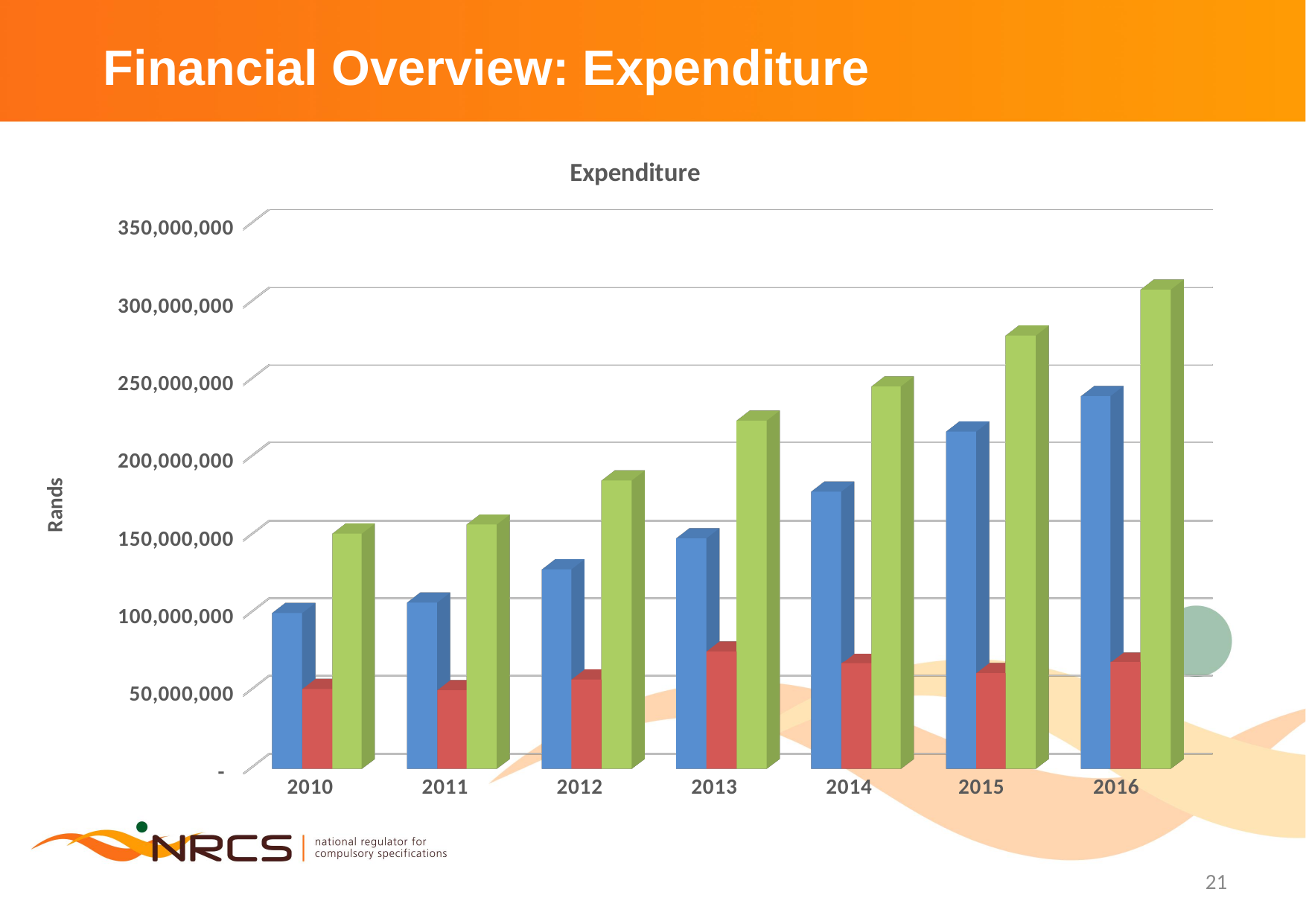
In which year is the green bar the shortest? 2010 Which is larger in 2013: the blue bar or the green bar? The green bar Do the green bars rise or fall from 2010 to 2016? Rise How many years are shown on the x axis of the Expenditure chart? 7 In which year is the blue bar the tallest? 2016 How many data series (bar colours) are plotted for each year in the Expenditure chart? 3 Is the value of the green bar for 2016 greater or less than 250,000,000? greater Is the value of the blue bar for 2014 greater or less than 200,000,000? less In which year is the green bar the tallest? 2016 What kind of chart is shown on the slide? Bar chart What is the title of the chart? Expenditure What is the label on the vertical axis of the chart? Rands